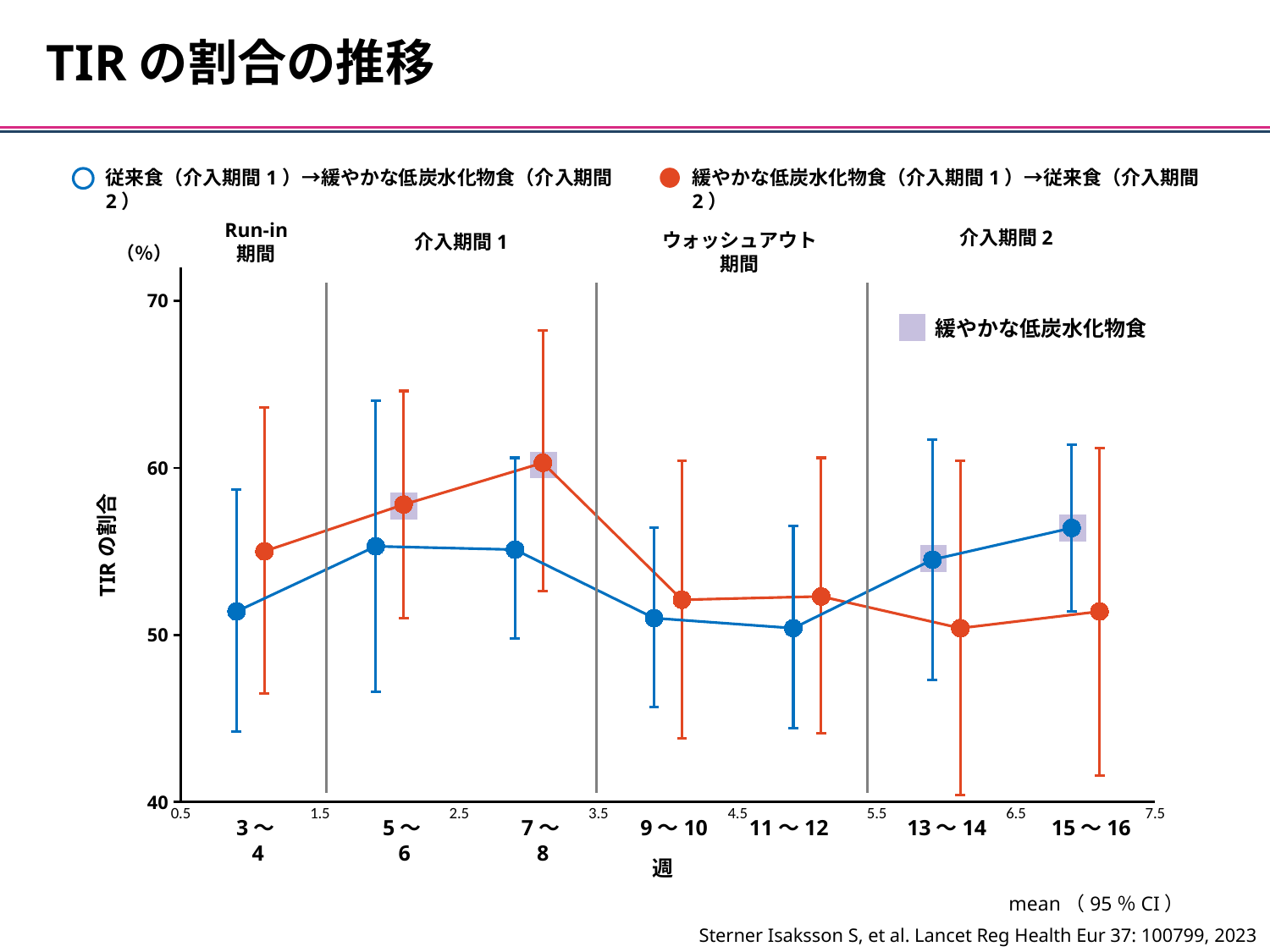
What is the title of the chart? TIR の割合の推移 What kind of chart is shown on the slide? Line chart with error bars Is the value of the red series at week 7～8 greater or less than 50? greater At week 7～8, which series has the larger value, the blue series or the red series? Red series Does the red series rise or fall from week 7～8 to week 9～10? Fall At week 15～16, which series has the larger value, the blue series or the red series? Blue series Is the value of the blue series at week 3～4 greater or less than 60? less At which week category does the red series (緩やかな低炭水化物食→従来食) reach its highest value? 7～8 How many week categories are plotted along the x axis? 7 How many series does the legend list? 2 At week 3～4, which series has the larger value, the blue series or the red series? Red series Which series is plotted in red: 従来食（介入期間1）→緩やかな低炭水化物食（介入期間2） or 緩やかな低炭水化物食（介入期間1）→従来食（介入期間2）? 緩やかな低炭水化物食（介入期間1）→従来食（介入期間2）